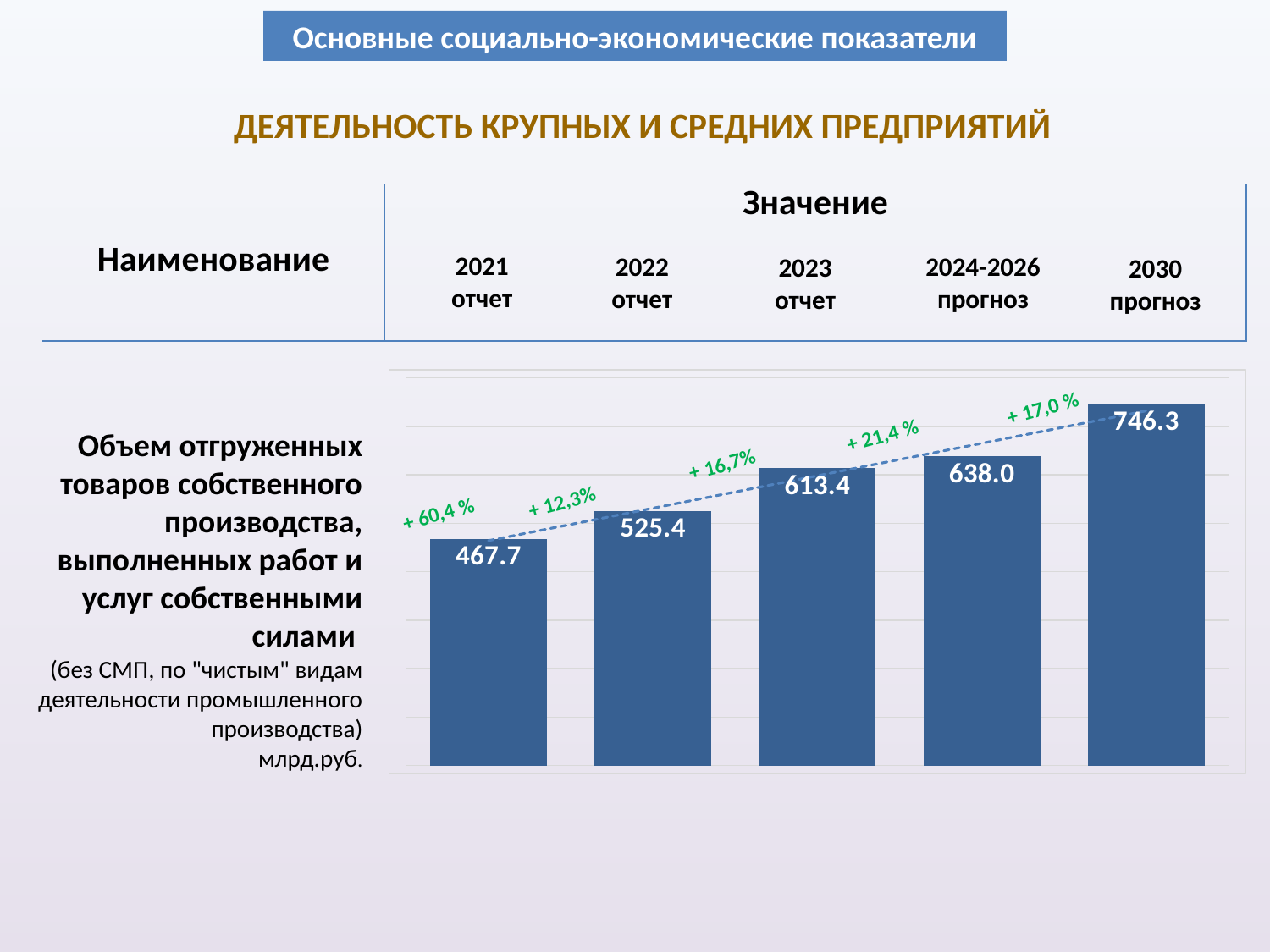
What is the value of the bar for 2021 (отчет)? 467.7 Which period has the highest bar in the chart? 2030 прогноз Do the bar values rise or fall from 2021 to 2030? Rise What is the value of the bar for the 2030 forecast (прогноз)? 746.3 What is the value of the bar for the 2024-2026 forecast? 638.0 What is the value of the bar for 2023 (отчет)? 613.4 How many bars are plotted in the chart? 5 Which is larger, the value for 2022 or the value for 2024-2026? 2024-2026 Which period has the lowest bar in the chart? 2021 отчет What is the difference between the 2023 value and the 2022 value? 88.0 What type of chart is shown on the slide? Bar chart What is the difference between the 2030 value and the 2021 value? 278.6